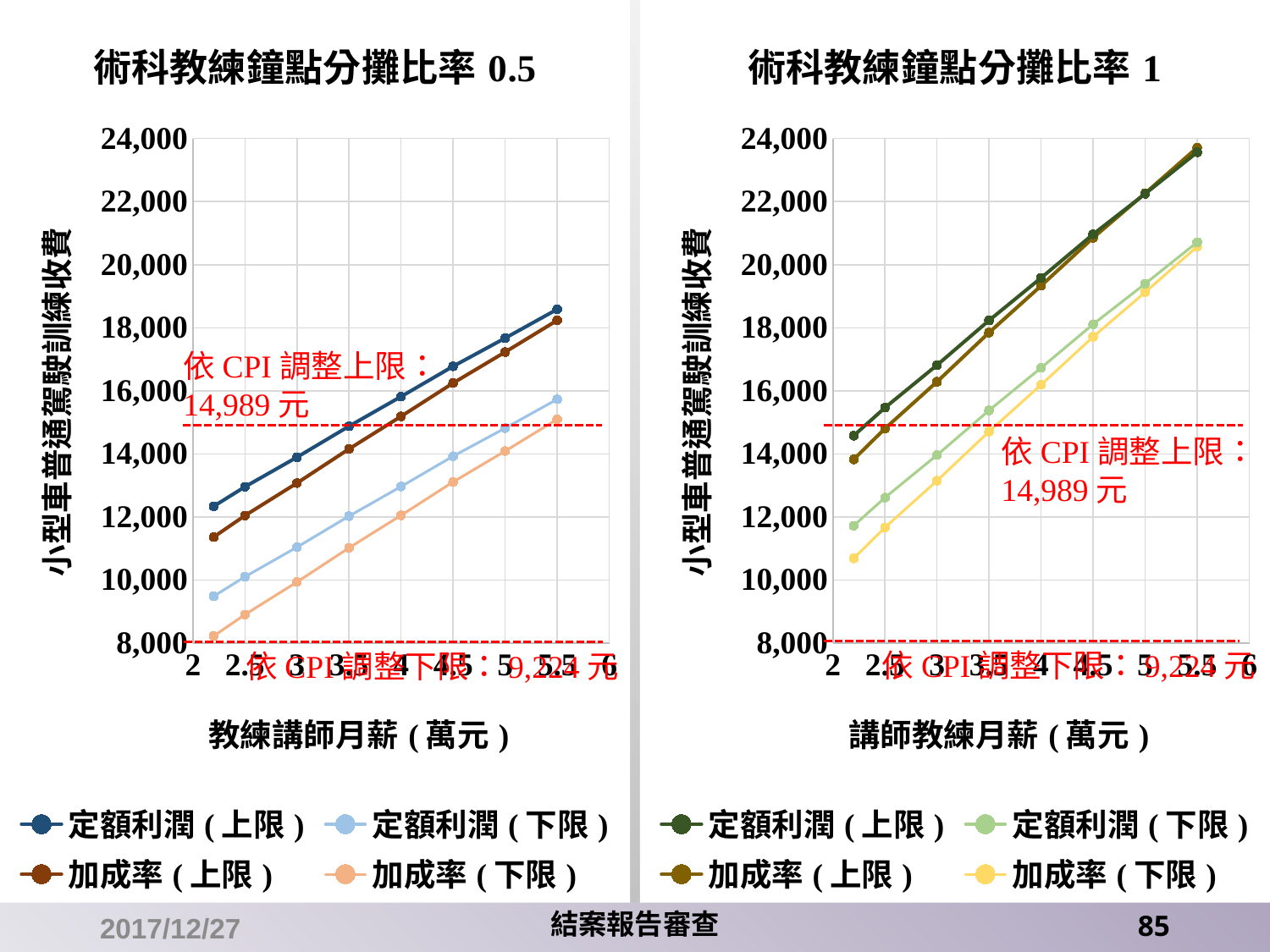
In the left chart (術科教練鐘點分攤比率 0.5), which series has the highest values across the x axis? 定額利潤(上限) What is the title of the right chart? 術科教練鐘點分攤比率 1 How many series does the legend of the right chart (術科教練鐘點分攤比率 1) list? 4 In the left chart (術科教練鐘點分攤比率 0.5), how many data points does the 定額利潤(上限) series have? 8 In the left chart (術科教練鐘點分攤比率 0.5), is the value of 定額利潤(上限) at 月薪 5.5 greater or less than 18,000? greater In the left chart (術科教練鐘點分攤比率 0.5), do the values of 加成率(上限) rise or fall as 教練講師月薪 increases? rise In the left chart (術科教練鐘點分攤比率 0.5), which series has the lowest values across the x axis? 加成率(下限) In the right chart (術科教練鐘點分攤比率 1), is the value of 定額利潤(上限) at 月薪 5.5 greater or less than 22,000? greater In the right chart (術科教練鐘點分攤比率 1), at 月薪 4, which is larger: 定額利潤(上限) or 定額利潤(下限)? 定額利潤(上限) What kind of chart is the left chart titled 術科教練鐘點分攤比率 0.5? line chart In the left chart (術科教練鐘點分攤比率 0.5), is the value of 加成率(下限) at 月薪 2.5 greater or less than 10,000? less According to the annotation on the left chart, what is the 依 CPI 調整上限 value? 14,989 元